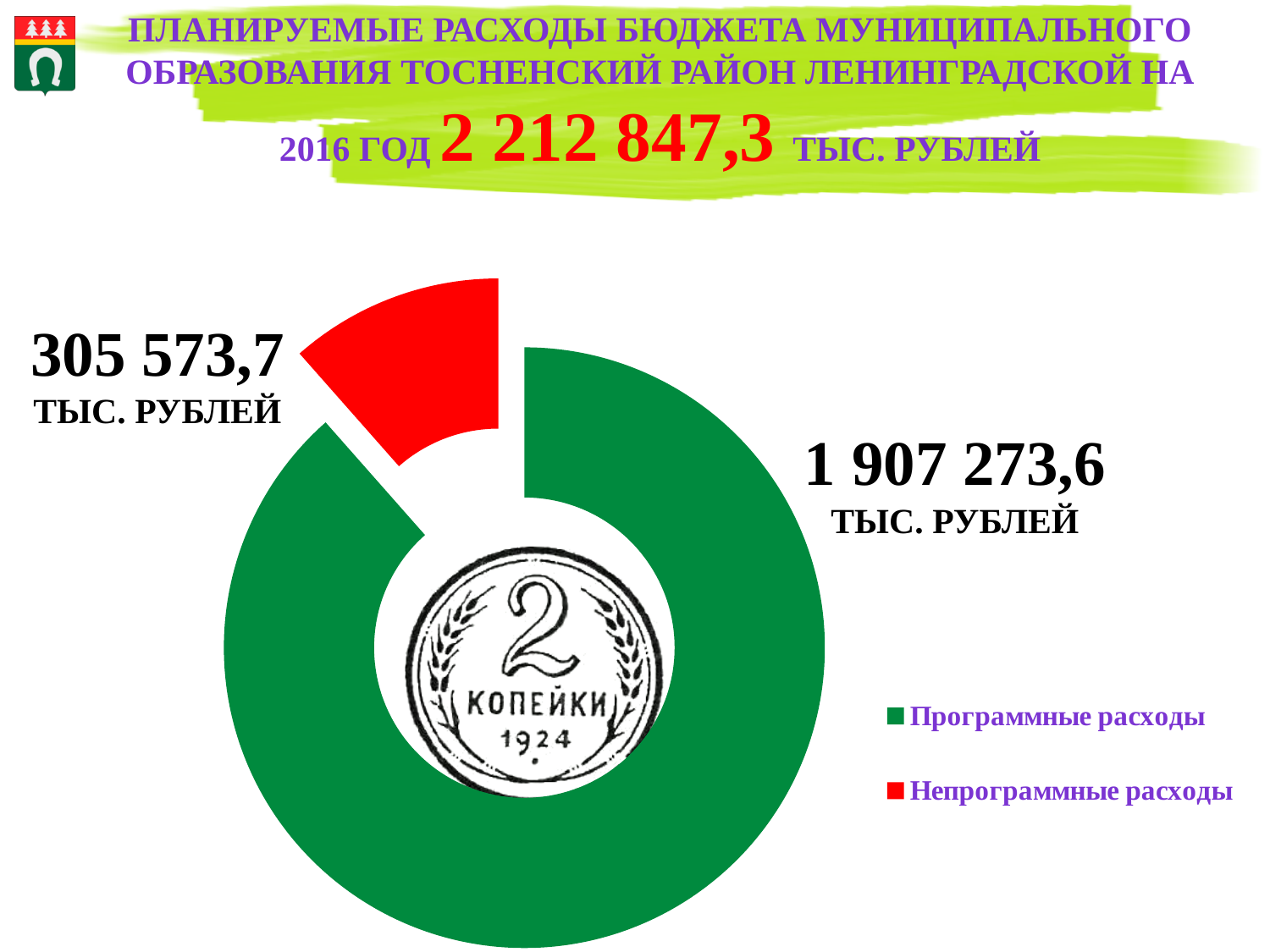
How many entries does the legend list? 2 What is the difference between Программные расходы and Непрограммные расходы? 1 601 699,9 тыс. рублей Which category has the smallest share of the chart? Непрограммные расходы How many categories does the chart show? 2 What kind of chart is shown on the slide? doughnut (pie) chart Which is larger, Программные расходы or Непрограммные расходы? Программные расходы What is the value for Непрограммные расходы? 305 573,7 тыс. рублей What colour represents Непрограммные расходы in the chart? red What is the total of the two categories shown in the chart? 2 212 847,3 тыс. рублей Which category has the largest share of the chart? Программные расходы What is the value for Программные расходы? 1 907 273,6 тыс. рублей What colour represents Программные расходы in the chart? green